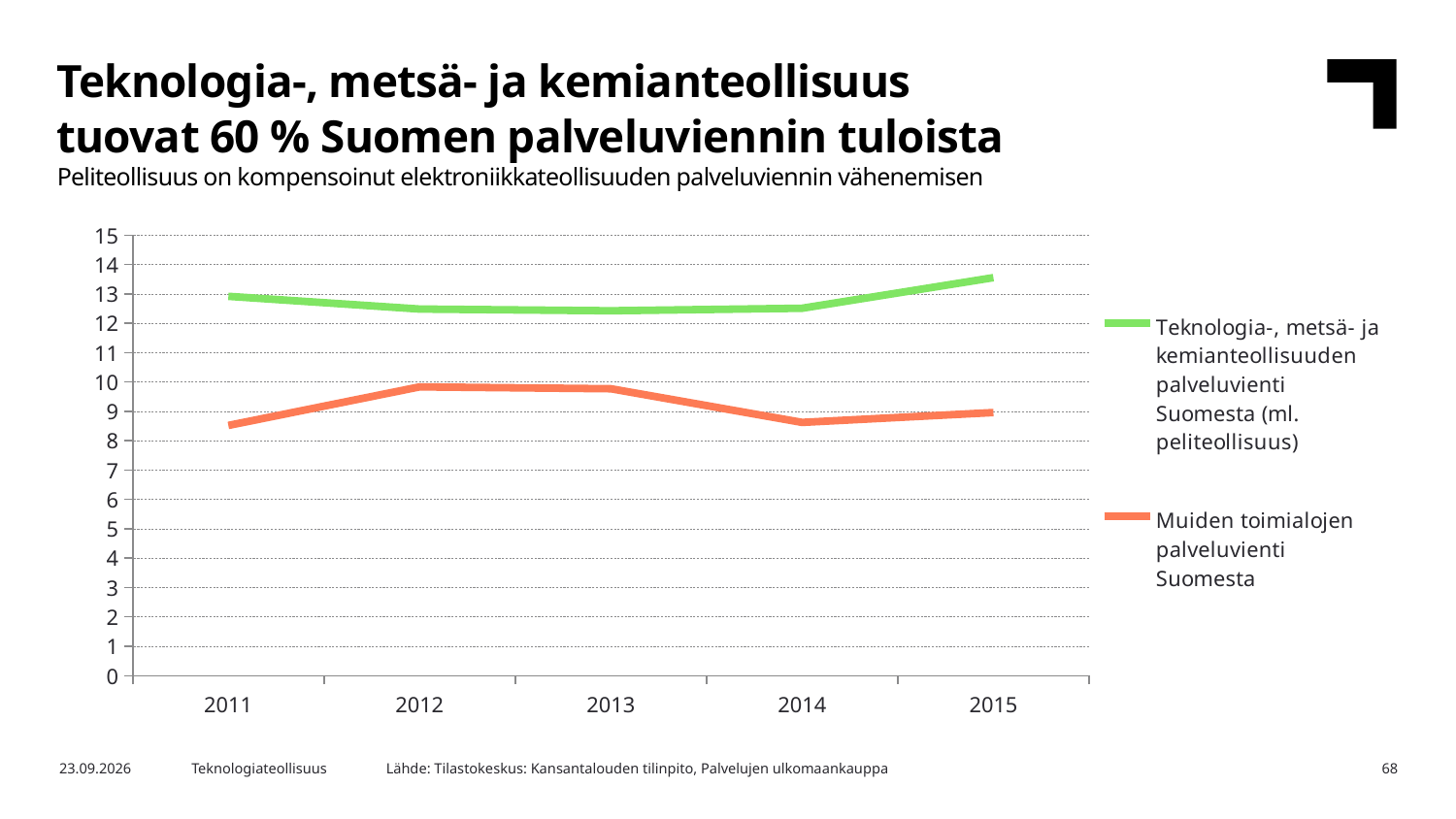
Is the value for Teknologia-, metsä- ja kemianteollisuuden palveluvienti Suomesta in 2015 greater or less than 13? greater How many years are shown on the x axis? 5 Does the Teknologia-, metsä- ja kemianteollisuuden palveluvienti Suomesta series rise or fall from 2014 to 2015? rise Is the value for Muiden toimialojen palveluvienti Suomesta in 2014 greater or less than 9? less For Muiden toimialojen palveluvienti Suomesta, is the value larger in 2011 or in 2012? 2012 Which colour is used for the Muiden toimialojen palveluvienti Suomesta series? orange In 2013, which series has the larger value: Teknologia-, metsä- ja kemianteollisuuden palveluvienti Suomesta or Muiden toimialojen palveluvienti Suomesta? Teknologia-, metsä- ja kemianteollisuuden palveluvienti Suomesta What kind of chart is shown on the slide? line chart How many series does the legend list? 2 Is the value for Teknologia-, metsä- ja kemianteollisuuden palveluvienti Suomesta in 2013 greater or less than 12? greater Which year has the highest value for the Teknologia-, metsä- ja kemianteollisuuden palveluvienti Suomesta series? 2015